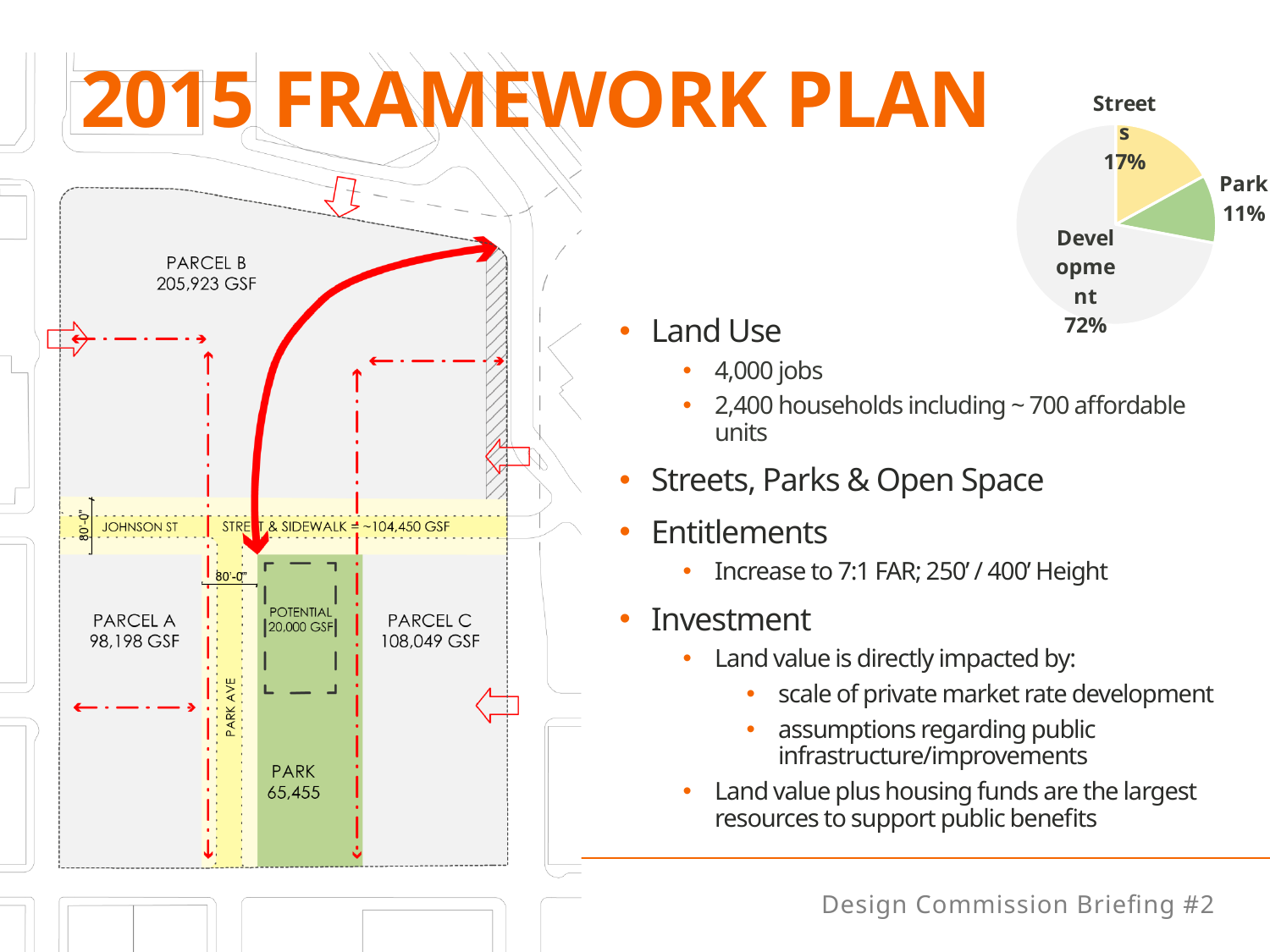
How many slices does the pie chart have? 3 In the pie chart, what share is labelled for Park? 11% In the pie chart, what is the combined share of Streets and Park? 28% In the pie chart, what share is labelled for Streets? 17% What colour is the Park slice in the pie chart? green What kind of chart is shown in the top right of the slide? pie chart Which slice of the pie chart is the smallest? Park In the pie chart, which is larger, Streets or Park? Streets In the pie chart, what is the difference in percentage points between Streets and Park? 6 Which slice of the pie chart is the largest? Development In the pie chart, what share is labelled for Development? 72% In the pie chart, what is the difference in percentage points between Development and Streets? 55